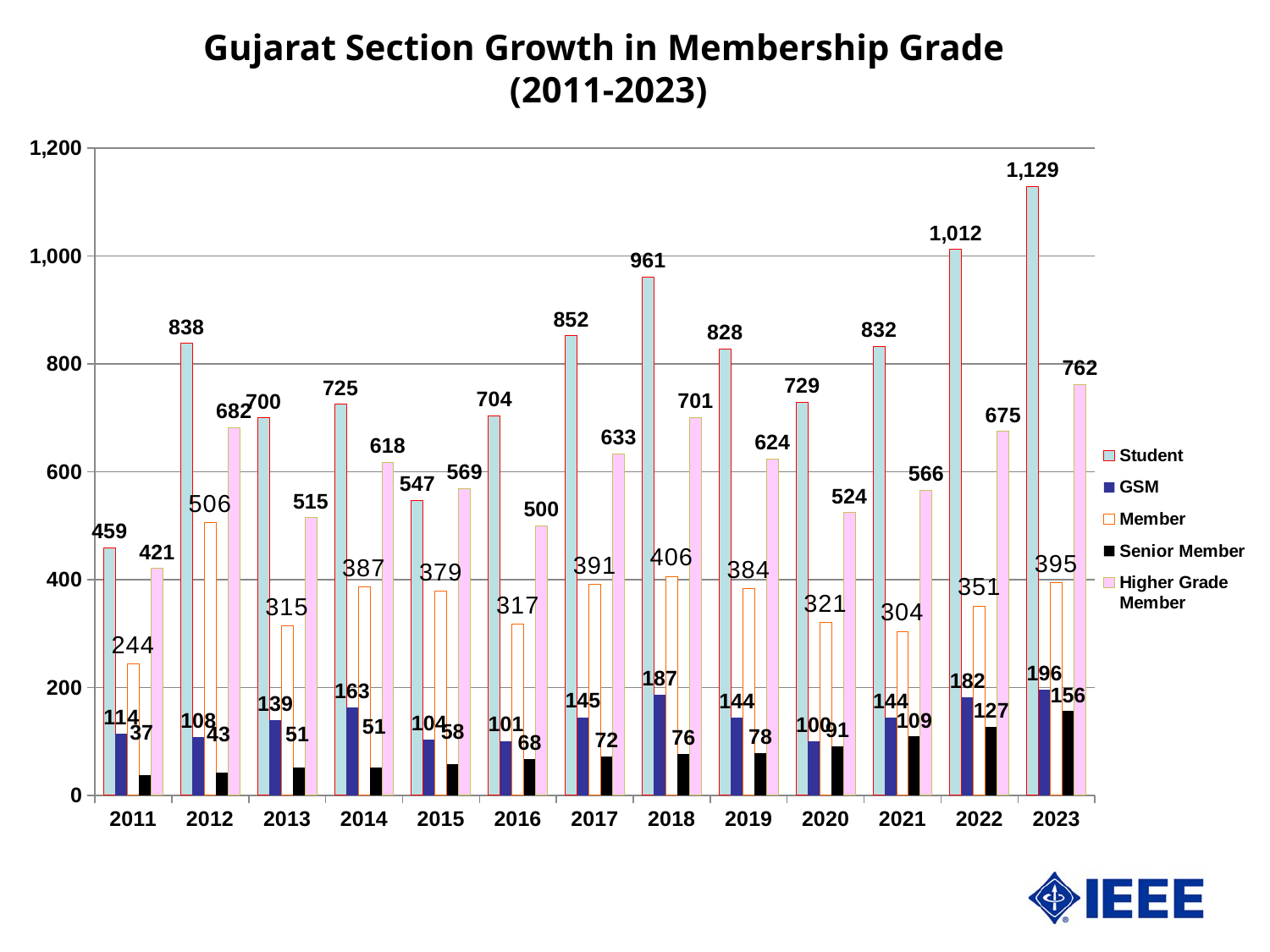
What is the difference between the Student values for 2022 and 2021? 180 In which year is the Student value highest? 2023 Does the Senior Member value rise or fall from 2011 to 2023? Rise What is the Higher Grade Member value for 2018? 701 In which year is the Senior Member value lowest? 2011 How many series does the legend list? 5 What is the Member value for 2012? 506 What kind of chart is this? Bar chart What is the Senior Member value for 2021? 109 How many years are shown on the x axis? 13 Which is larger, the GSM value for 2018 or the GSM value for 2022? 2018 What is the Student value for 2023? 1,129